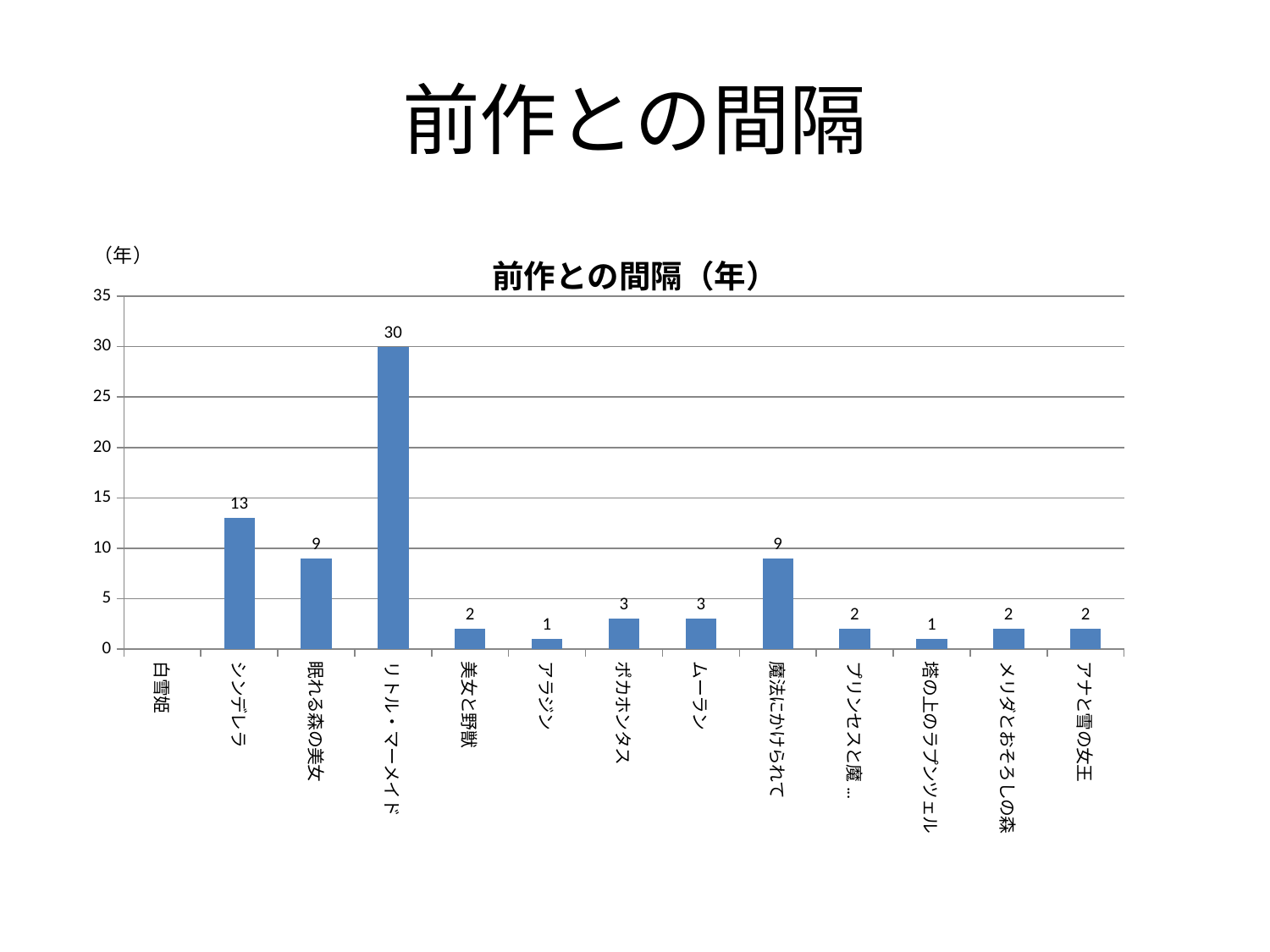
What kind of chart is shown on the slide? bar chart How many categories are shown on the x axis of the chart? 13 What is the value for シンデレラ in the chart? 13 Which is larger, the value for ポカホンタス or the value for アラジン? ポカホンタス What is the value for 魔法にかけられて in the chart? 9 What is the title of the chart? 前作との間隔（年） Which category has the highest value in the chart? リトル・マーメイド What is the difference between the values for リトル・マーメイド and シンデレラ? 17 What is the value for アナと雪の女王 in the chart? 2 Is the value for リトル・マーメイド greater or less than 25? greater What is the difference between the values for 眠れる森の美女 and 美女と野獣? 7 What is the value for リトル・マーメイド in the chart? 30